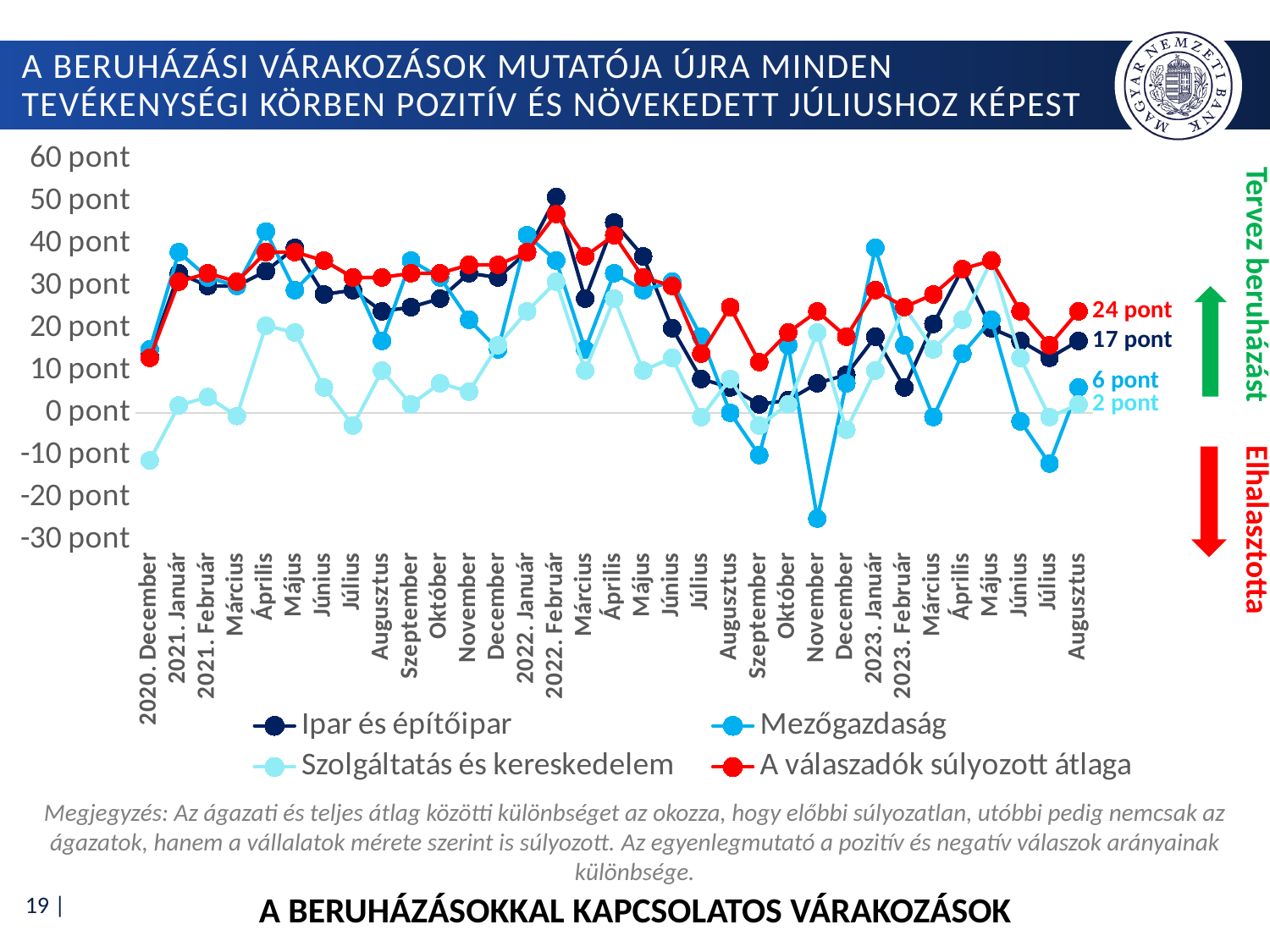
Is the value for 'Ipar és építőipar' in 2022. Február greater or less than 40 pont? greater What is the difference between 'A válaszadók súlyozott átlaga' and 'Ipar és építőipar' in Augusztus 2023? 7 pont What is the value of 'Mezőgazdaság' in Augusztus 2023? 6 pont How many months are shown on the x axis? 33 What kind of chart is shown on the slide? line chart What is the value of 'A válaszadók súlyozott átlaga' in Augusztus 2023? 24 pont What is the value of 'Szolgáltatás és kereskedelem' in Augusztus 2023? 2 pont Which series has the highest value in Augusztus 2023? A válaszadók súlyozott átlaga Is the value for 'Mezőgazdaság' in 2022 November greater or less than -20 pont? less Which series has the lowest value in Augusztus 2023? Szolgáltatás és kereskedelem What is the value of 'Ipar és építőipar' in Augusztus 2023? 17 pont How many series does the legend list? 4